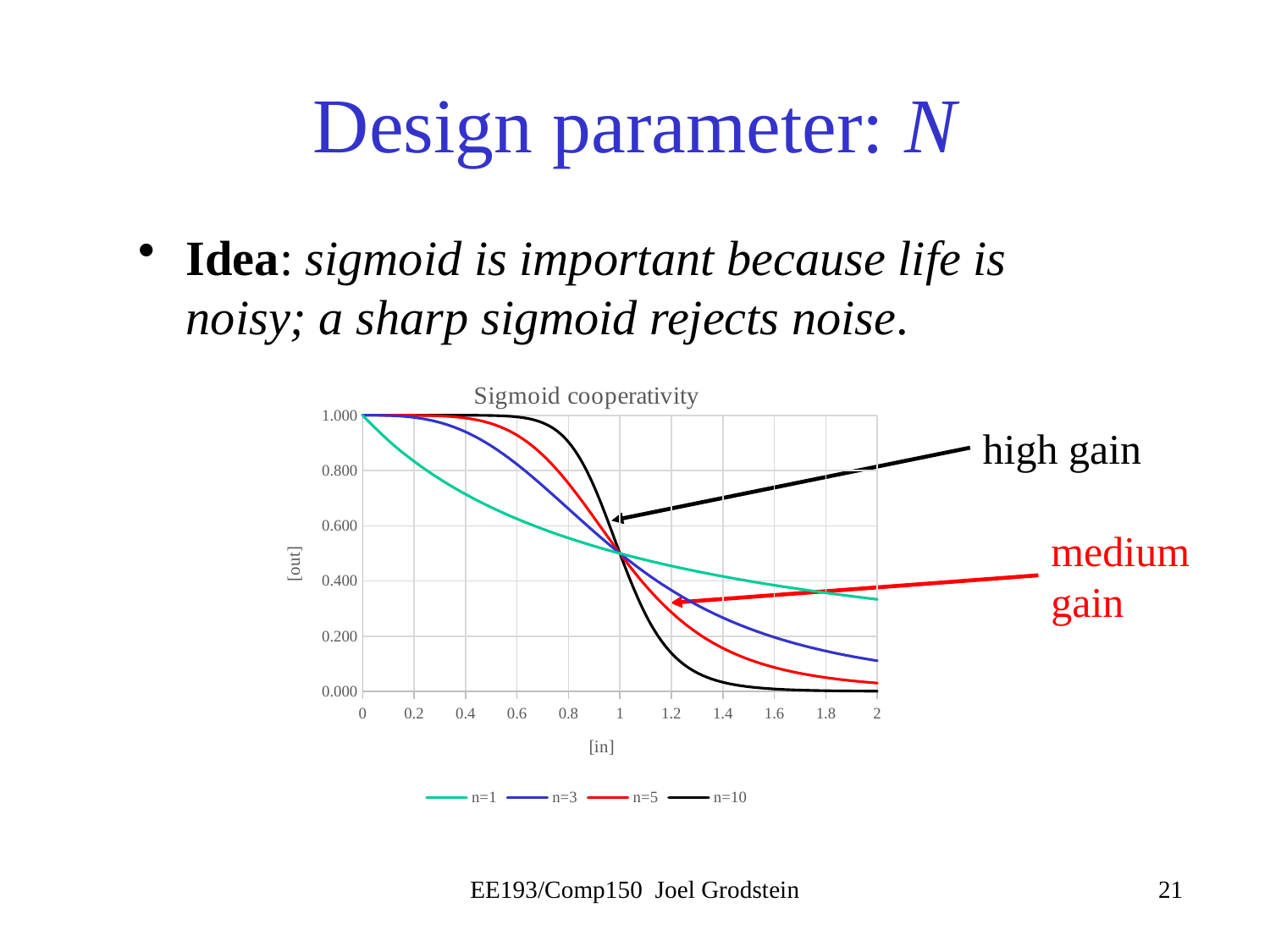
Do the values of the n=10 series rise or fall as [in] increases from 0 to 2? fall What is the title of the chart? Sigmoid cooperativity Is the [out] value of the n=1 series at [in] = 2 greater or less than 0.200? greater How many series does the legend of the chart list? 4 What is the [out] value of the n=10 series at [in] = 0? 1.000 Is the [out] value of the n=3 series at [in] = 2 greater or less than 0.200? less At [in] = 0.6, which series has the larger [out] value, n=10 or n=1? n=10 Is the [out] value of the n=1 series at [in] = 2 greater or less than 0.400? less At [in] = 2, which series has the larger [out] value, n=1 or n=3? n=1 What kind of chart is shown on the slide? line chart What is the label of the x axis of the chart? [in]